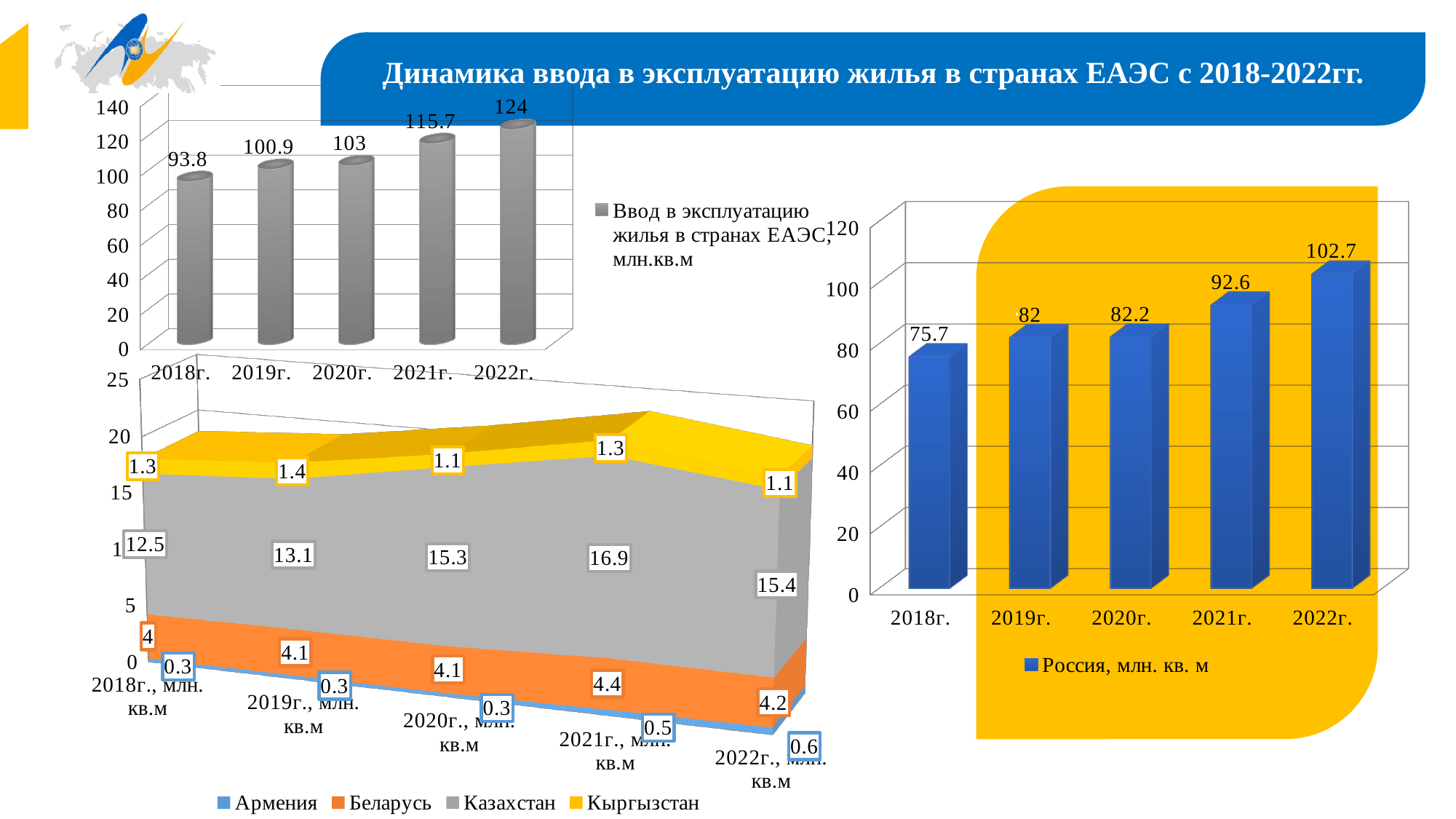
In the bottom-left chart, what is the value for Беларусь in 2022г.? 4.2 In the bottom-left chart, how many series does the legend list? 4 In the right chart (Россия, млн. кв. м), which year has the highest value? 2022г. In the top-left chart, what is the value for 2022г.? 124 In the bottom-left chart, what is the value for Казахстан in 2021г.? 16.9 In the right chart (Россия, млн. кв. м), what is the difference between the values for 2022г. and 2018г.? 27 In the top-left chart, what is the difference between the values for 2022г. and 2018г.? 30.2 In the top-left chart, which year has the lowest value? 2018г. In the bottom-left chart, which is larger in 2020г.: Кыргызстан or Беларусь? Беларусь In the top-left chart, what is the value for 2019г.? 100.9 In the top-left chart, do the values rise or fall from 2018г. to 2022г.? rise In the right chart (Россия, млн. кв. м), what is the value for 2021г.? 92.6